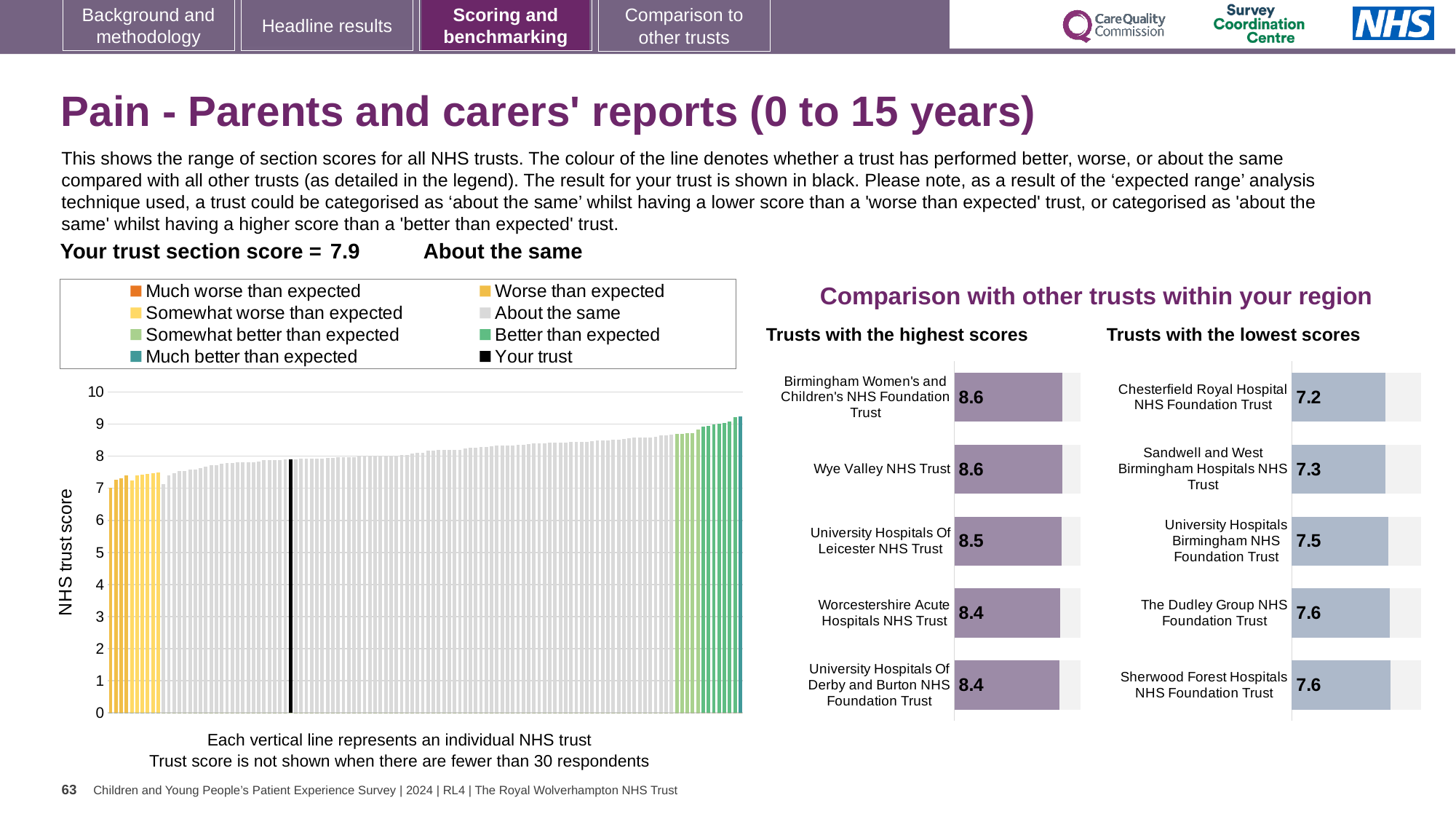
In the 'Trusts with the lowest scores' chart, what is the score for University Hospitals Birmingham NHS Foundation Trust? 7.5 In the main chart on the left showing all NHS trusts, what is the section score for your trust (the black line)? 7.9 In the 'Trusts with the lowest scores' chart, what is the difference between the score for Sherwood Forest Hospitals NHS Foundation Trust and the score for Chesterfield Royal Hospital NHS Foundation Trust? 0.4 In the main chart on the left showing all NHS trusts, do the trust scores rise or fall from left to right? rise In the 'Trusts with the lowest scores' chart, which trust has the lowest score? Chesterfield Royal Hospital NHS Foundation Trust In the 'Trusts with the highest scores' chart, what is the difference between the score for Birmingham Women's and Children's NHS Foundation Trust and the score for University Hospitals Of Derby and Burton NHS Foundation Trust? 0.2 How many entries does the legend of the main chart on the left list? 8 In the 'Trusts with the lowest scores' chart, what is the score for Chesterfield Royal Hospital NHS Foundation Trust? 7.2 In the 'Trusts with the highest scores' chart, what is the score for Wye Valley NHS Trust? 8.6 In the 'Trusts with the highest scores' chart, what is the score for Worcestershire Acute Hospitals NHS Trust? 8.4 In the 'Trusts with the lowest scores' chart, which has the larger score: The Dudley Group NHS Foundation Trust or Sandwell and West Birmingham Hospitals NHS Trust? The Dudley Group NHS Foundation Trust How many trusts are shown in the 'Trusts with the highest scores' chart? 5